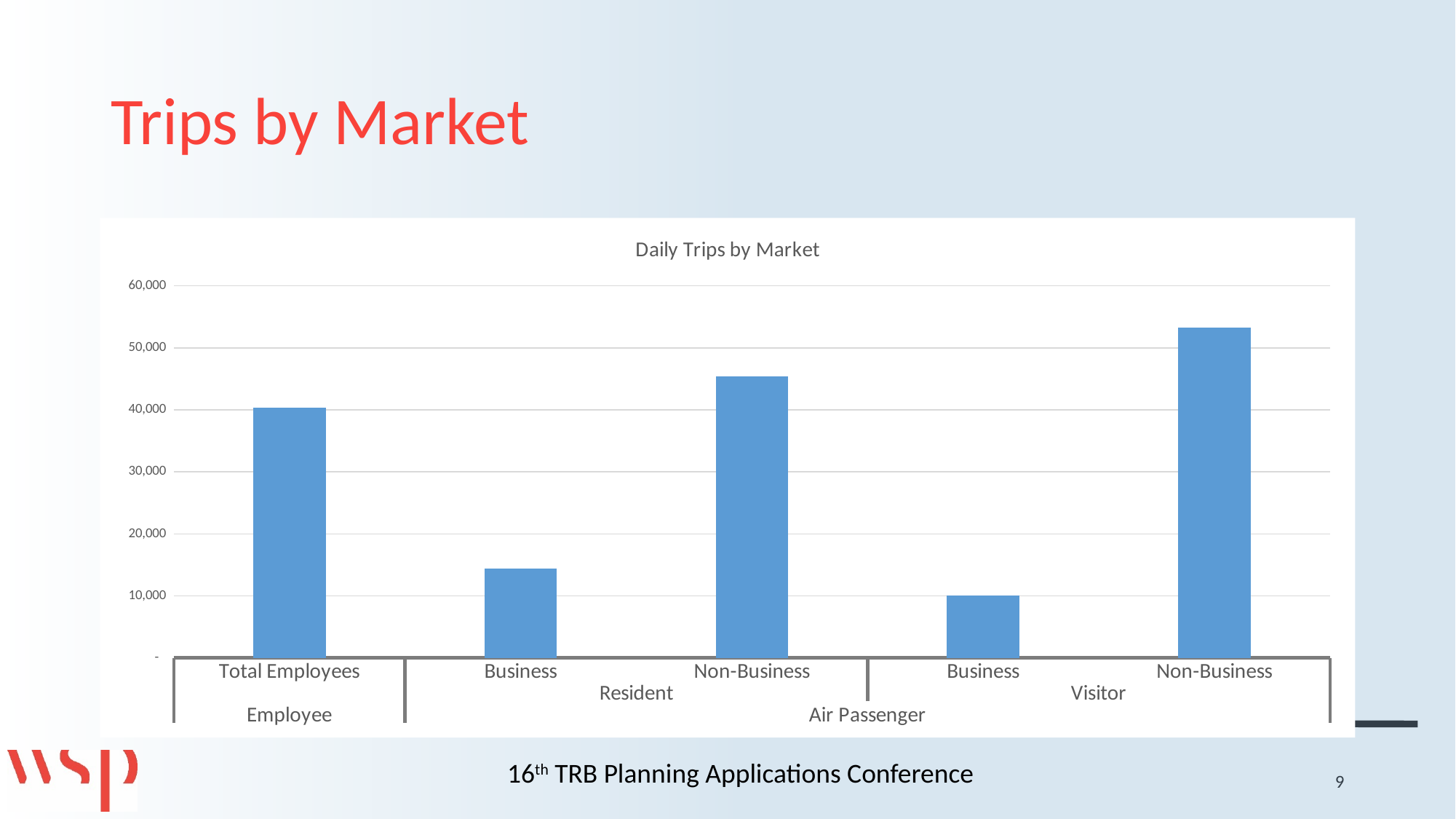
What kind of chart is shown on the slide? bar chart Is the value for Total Employees greater or less than 30,000? greater Which is larger, the value for Resident Business or the value for Visitor Business? Resident Business What is the title of the chart? Daily Trips by Market Which category has the lowest number of daily trips? Visitor Business How many bars are plotted in the chart? 5 Which category has the highest number of daily trips? Visitor Non-Business What is the highest value shown on the vertical axis? 60,000 Is the value for Resident Non-Business greater or less than 50,000? less Is the value for Resident Business greater or less than 20,000? less Which is larger, the value for Resident Non-Business or the value for Total Employees? Resident Non-Business